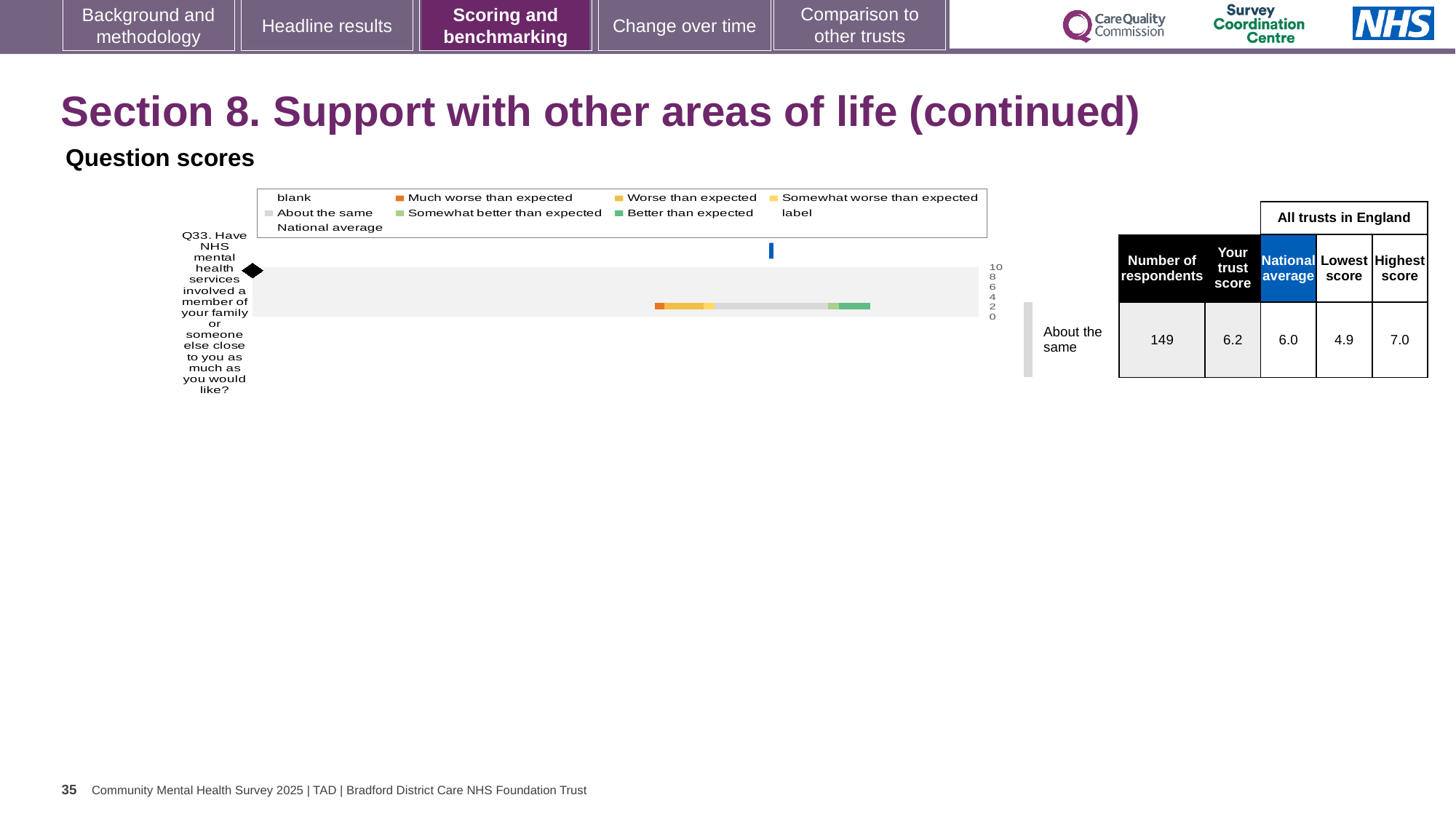
In the table beside the chart, what is the number of respondents for Q33? 149 For Q33, what is the difference between the trust's score and the national average? 0.2 How many questions are plotted in the chart? 1 In the table beside the chart, what is the national average for Q33? 6.0 For Q33, what is the difference between the highest and lowest scores among all trusts in England? 2.1 In the table beside the chart, what is the trust's score for Q33? 6.2 What benchmark category is shown for Q33 next to the chart? About the same In the table beside the chart, what is the highest score among all trusts in England for Q33? 7.0 In the table beside the chart, what is the lowest score among all trusts in England for Q33? 4.9 For Q33, which is larger: the trust's score or the national average? the trust's score What kind of chart is shown on the slide? bar chart Which question number is plotted in the chart? Q33